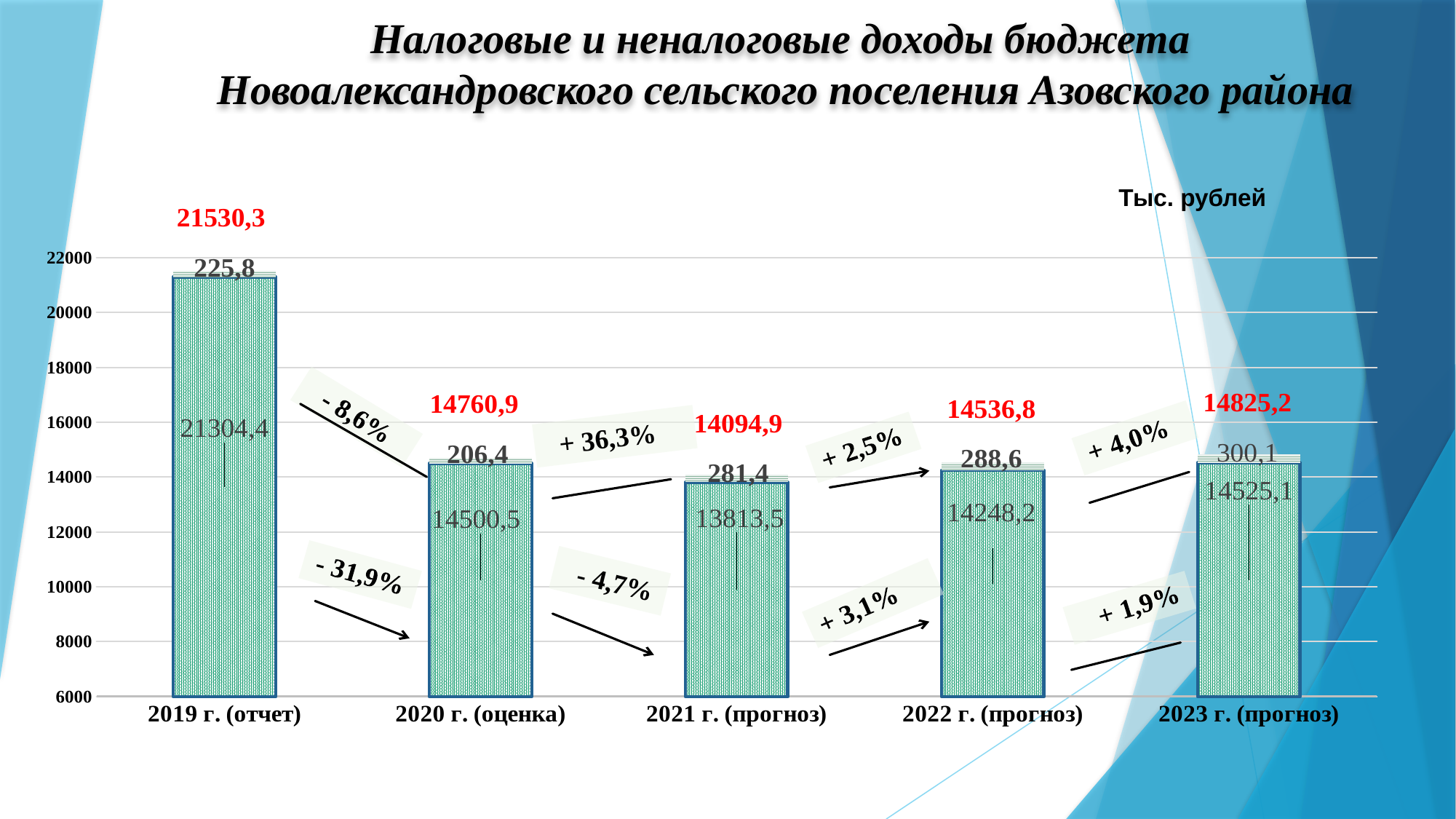
What unit of measurement is indicated in the top right of the chart? Тыс. рублей What is the smaller (upper segment) value printed on the bar for 2022 г. (прогноз)? 288,6 What is the difference between the lower segment values for 2019 г. (отчет) and 2020 г. (оценка), i.e. 21304,4 minus 14500,5? 6803,9 What is the larger (lower segment) value printed inside the bar for 2021 г. (прогноз)? 13813,5 How many year categories are shown on the x axis of the chart? 5 Is the total for 2020 г. (оценка) larger or smaller than the total for 2022 г. (прогноз)? larger Which year has the highest total value? 2019 г. (отчет) What is the total value printed in red above the bar for 2019 г. (отчет)? 21530,3 Which year has the lowest total value? 2021 г. (прогноз) What kind of chart is shown on the slide? bar chart What is the smaller (upper segment) value printed on the bar for 2020 г. (оценка)? 206,4 What is the total value printed in red above the bar for 2023 г. (прогноз)? 14825,2